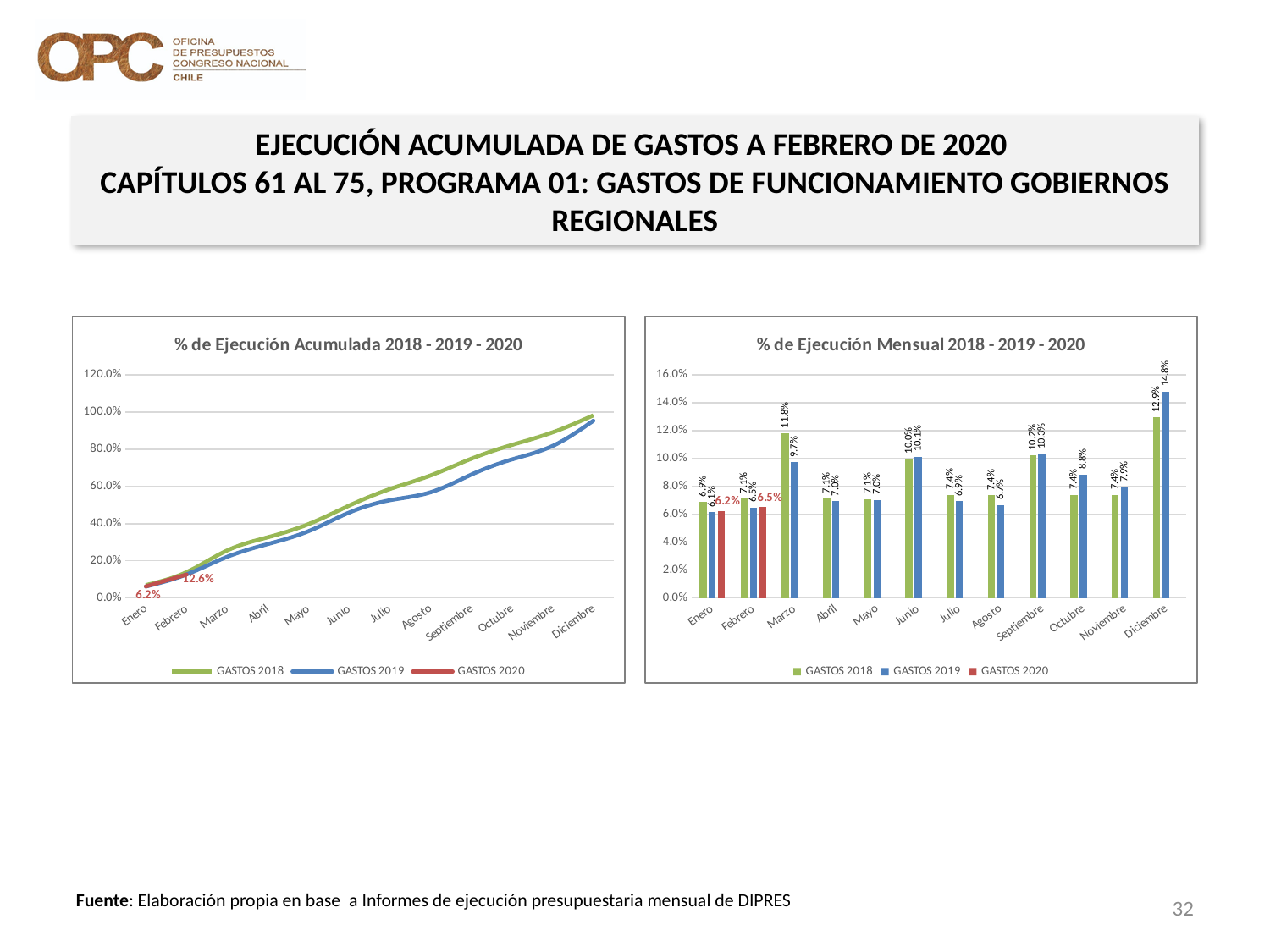
How many series does the legend of the left chart '% de Ejecución Acumulada' list? 3 What kind of chart is the right chart, '% de Ejecución Mensual 2018 - 2019 - 2020'? Bar chart What kind of chart is the left chart, '% de Ejecución Acumulada 2018 - 2019 - 2020'? Line chart In the left chart '% de Ejecución Acumulada', is the GASTOS 2019 value for Diciembre greater or less than 80.0%? greater In the left chart '% de Ejecución Acumulada', what is the GASTOS 2020 value for Febrero? 12.6% In the right chart '% de Ejecución Mensual', what is the difference between the GASTOS 2019 and GASTOS 2018 values for Diciembre? 1.9 percentage points In the right chart '% de Ejecución Mensual', what is the GASTOS 2018 value for Marzo? 11.8% In the right chart '% de Ejecución Mensual', which month has the lowest GASTOS 2018 value? Enero In the right chart '% de Ejecución Mensual', which month has the highest GASTOS 2019 value? Diciembre In the left chart '% de Ejecución Acumulada', what is the GASTOS 2020 value for Enero? 6.2% In the right chart '% de Ejecución Mensual', what is the GASTOS 2019 value for Diciembre? 14.8% In the right chart '% de Ejecución Mensual', which is larger for Marzo: GASTOS 2018 or GASTOS 2019? GASTOS 2018